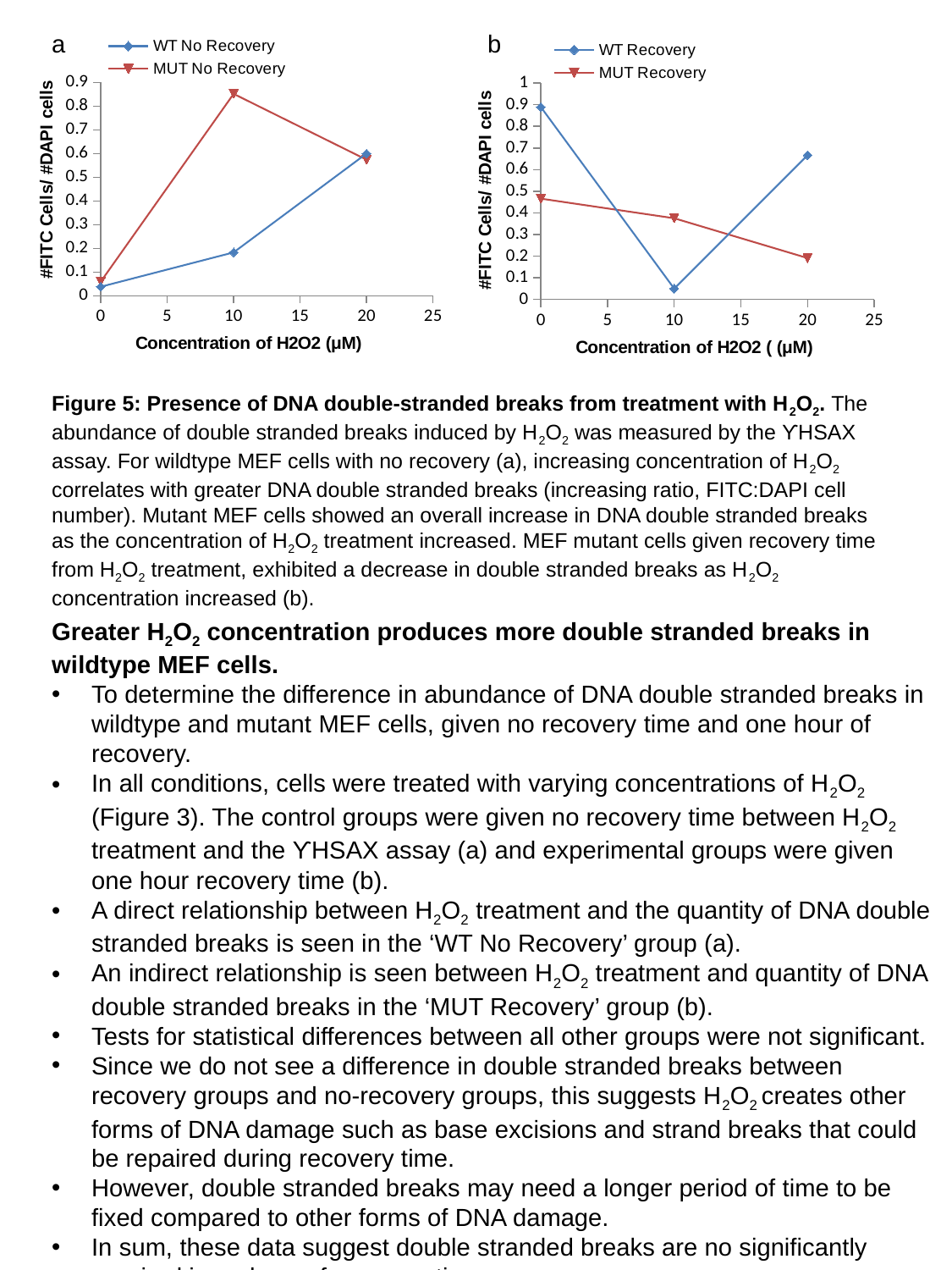
In chart a, which series has the higher value at 10 µM H2O2? MUT No Recovery In chart b, does the MUT Recovery series rise or fall as H2O2 concentration increases? fall In chart a, how many data points are plotted for the WT No Recovery series? 3 In chart a, does the WT No Recovery series rise or fall as H2O2 concentration increases? rise In chart a, is the value for WT No Recovery at 10 µM greater or less than 0.3? less In chart b, which series has the higher value at 20 µM H2O2? WT Recovery In chart b, at which H2O2 concentration is the WT Recovery value highest? 0 What kind of chart is chart a (WT No Recovery / MUT No Recovery)? line chart How many series does the legend of chart b list? 2 In chart a, is the value for MUT No Recovery at 10 µM greater or less than 0.5? greater In chart b, at which H2O2 concentration is the WT Recovery value lowest? 10 How many series does the legend of chart a list? 2